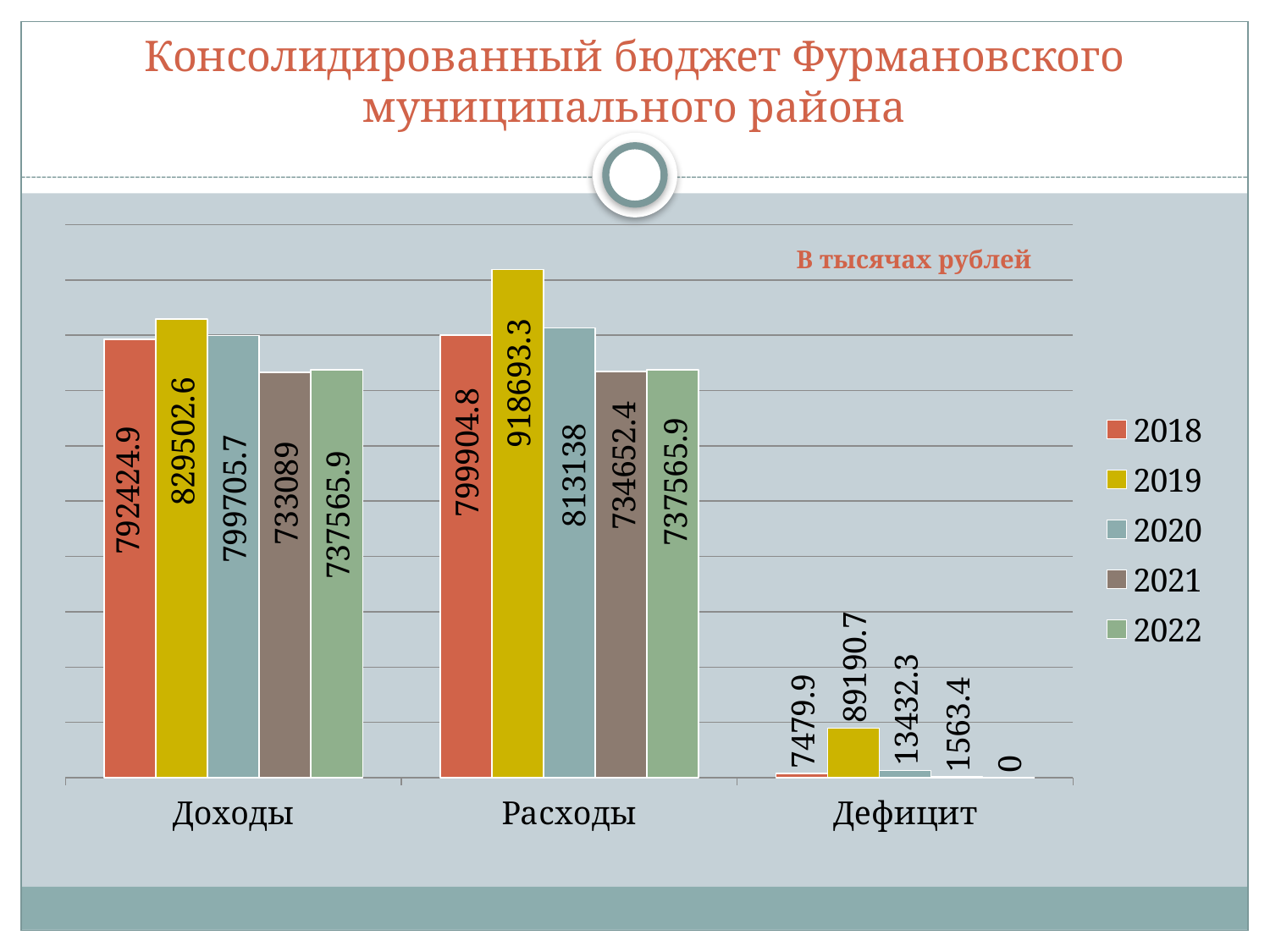
What is the value for Доходы in 2018? 792424.9 What is the difference between Расходы and Доходы in 2019? 89190.7 What is the value for Дефицит in 2021? 1563.4 How many categories are shown on the x axis? 3 Which is larger: Доходы in 2020 or Доходы in 2018? Доходы in 2020 Which year has the lowest value for Доходы? 2021 What is the value for Дефицит in 2022? 0 What is the value for Расходы in 2019? 918693.3 What kind of chart is shown on the slide? Bar chart How many series does the legend list? 5 What is the difference between Доходы in 2019 and Доходы in 2018? 37077.7 Which year has the highest value for Расходы? 2019